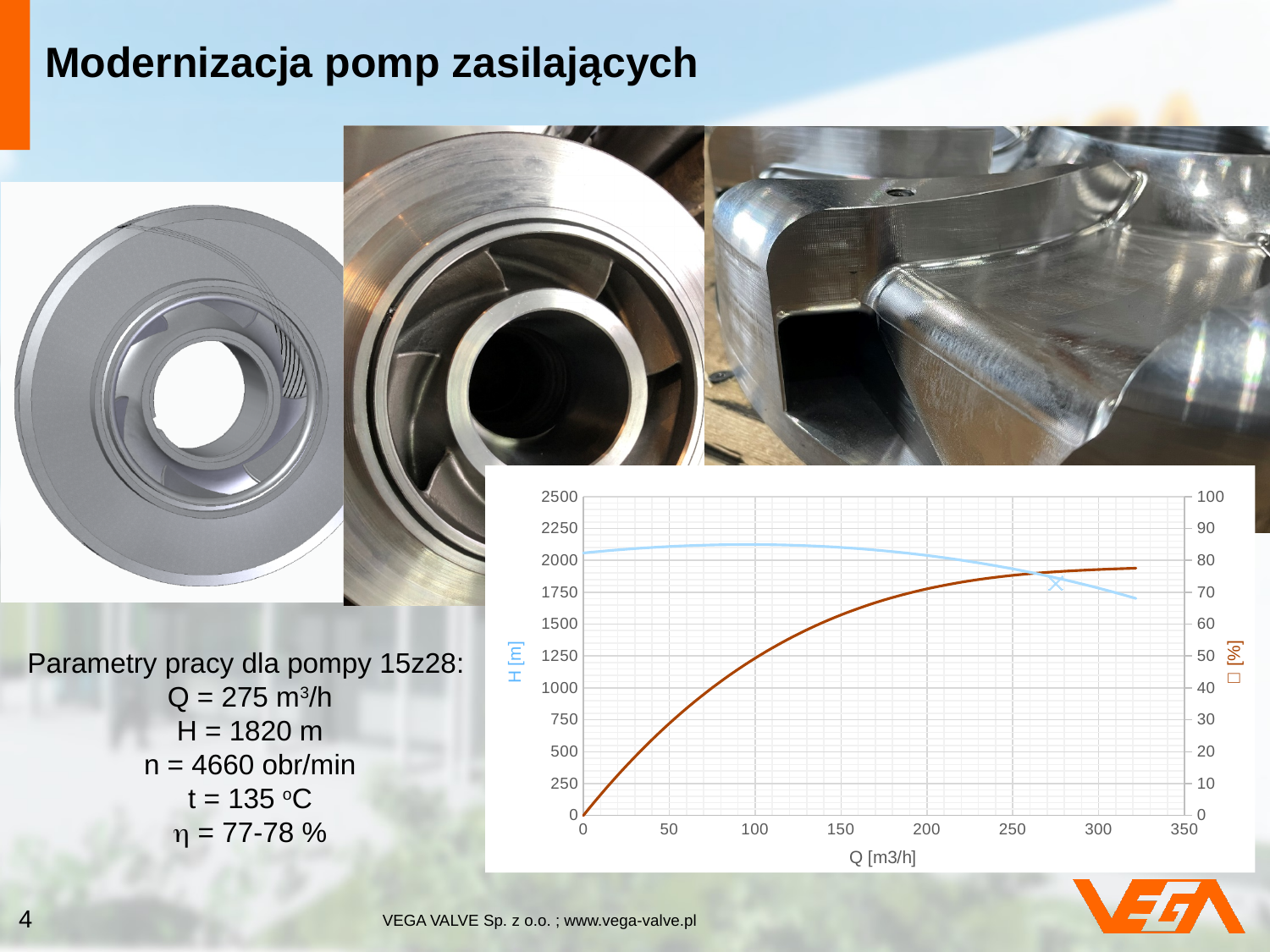
What is the value of the orange efficiency curve at Q = 0? 0 What is the highest value shown on the left vertical axis of the chart? 2500 Does the orange efficiency curve rise or fall as Q increases from 0 to 300? rise What kind of chart is shown on the slide? line chart Is the value of the blue H curve at Q = 100 greater or less than 2000? greater Is the value of the orange efficiency curve at Q = 150 greater or less than 50? greater Is the value of the orange efficiency curve at Q = 300 greater or less than 70? greater What is the label of the x axis of the chart? Q [m3/h] Does the blue H curve rise or fall as Q increases from 200 to 300? fall How many curves are plotted on the chart? 2 What is the label of the left vertical axis of the chart? H [m]